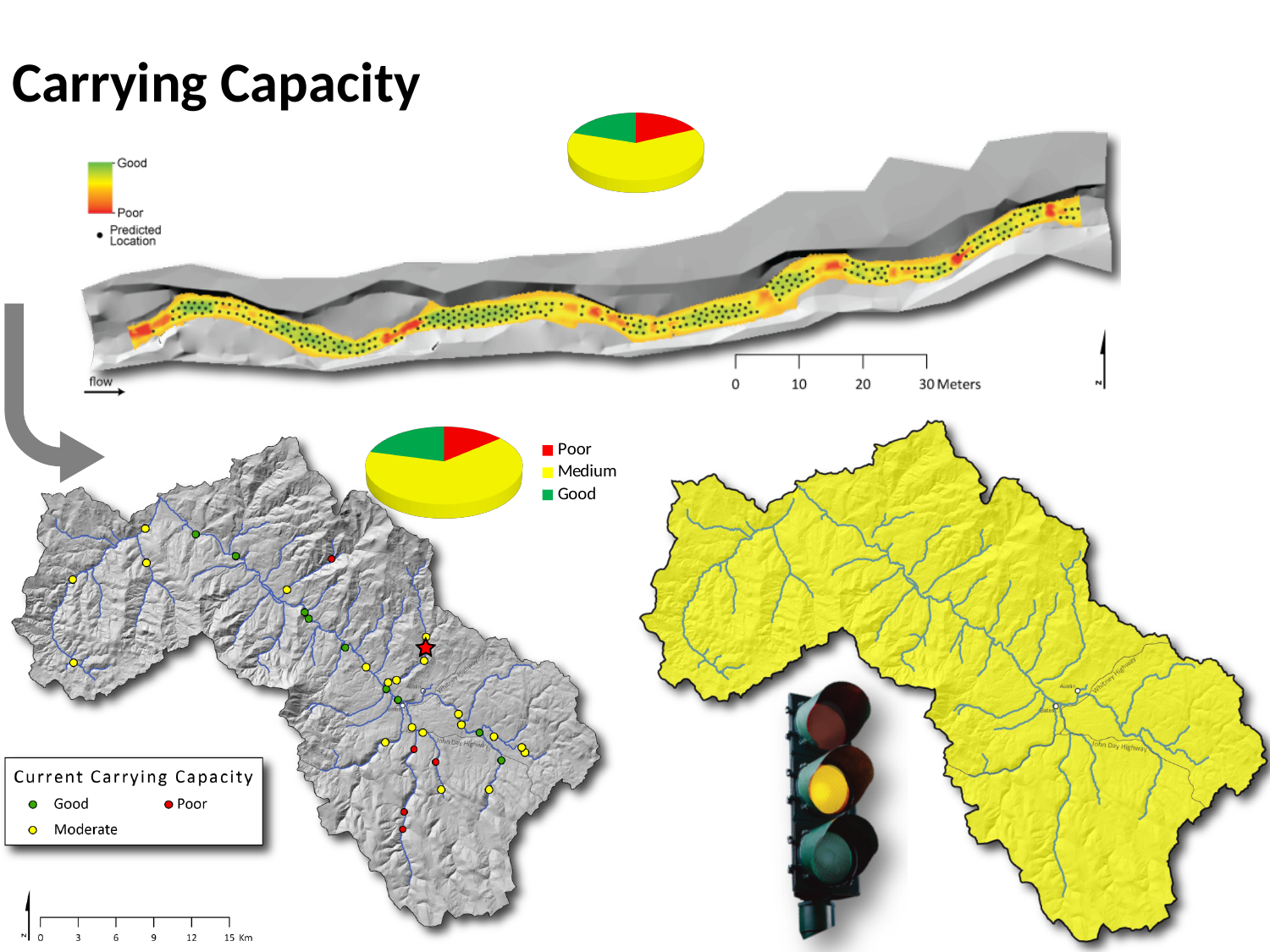
How many entries does the legend of the pie chart with the Poor/Medium/Good legend list? 3 In the pie chart at the top of the slide, is the yellow slice larger or smaller than the red slice? larger How many slices does the pie chart at the top of the slide have? 3 In the pie chart with the Poor/Medium/Good legend, which slice is larger, Medium or Good? Medium What kind of chart is the chart with the Poor/Medium/Good legend? pie chart What kind of chart is the chart at the top of the slide above the stream map? pie chart How many slices does the pie chart with the Poor/Medium/Good legend have? 3 In the pie chart with the Poor/Medium/Good legend, which slice is larger, Medium or Poor? Medium In the pie chart with the Poor/Medium/Good legend, what colour represents Medium? yellow In the pie chart with the Poor/Medium/Good legend, which category has the largest slice? Medium In the pie chart with the Poor/Medium/Good legend, what colour represents Poor? red